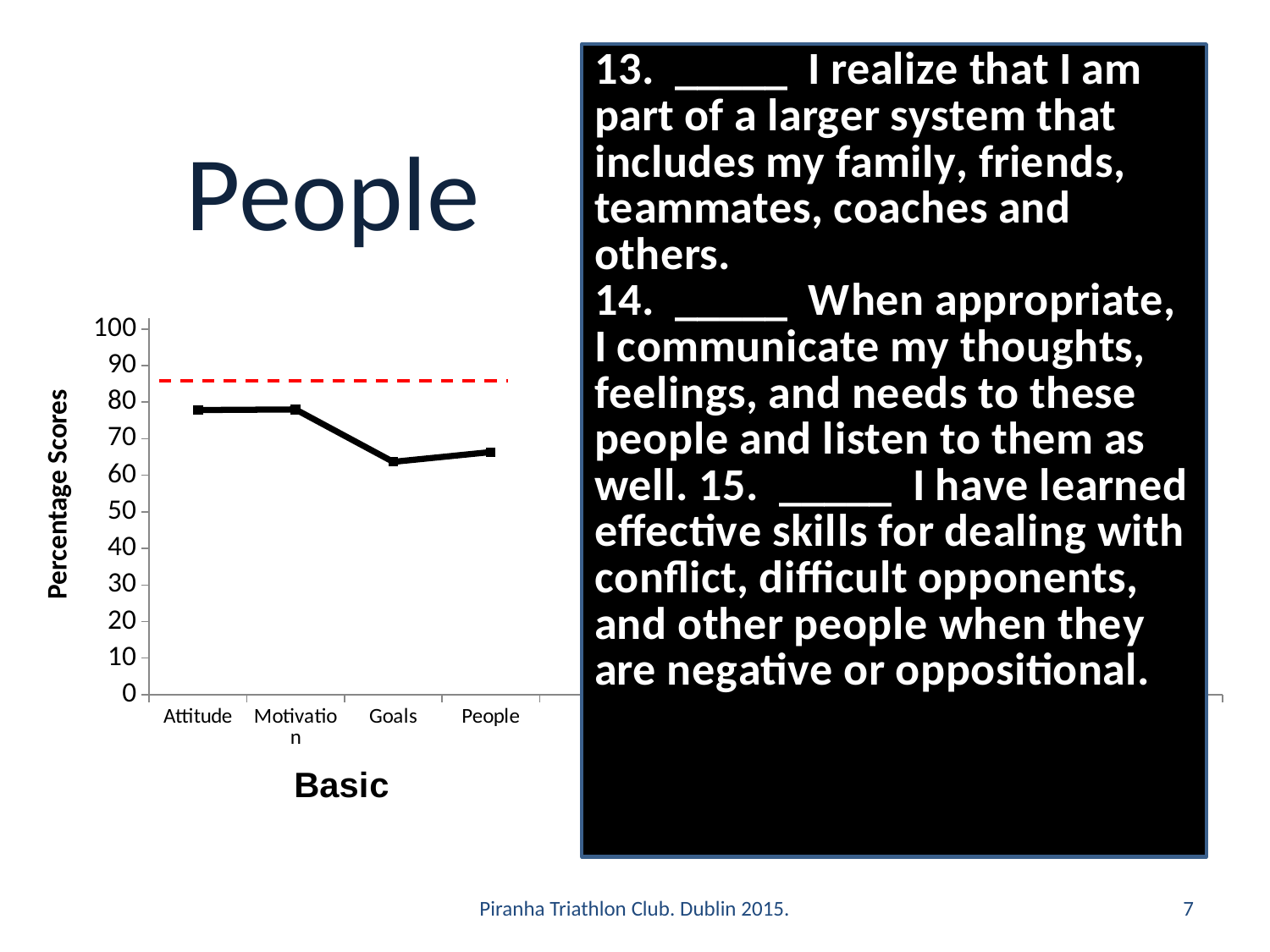
Is the value for Goals greater or less than 70? less What is the title of the vertical axis? Percentage Scores Is the value for Attitude greater or less than 70? greater Is the value for People greater or less than 70? less Which is larger, the value for Attitude or the value for Goals? Attitude Which is larger, the value for Motivation or the value for People? Motivation Does the line rise or fall from Motivation to Goals? fall What kind of chart is shown on the slide? line chart